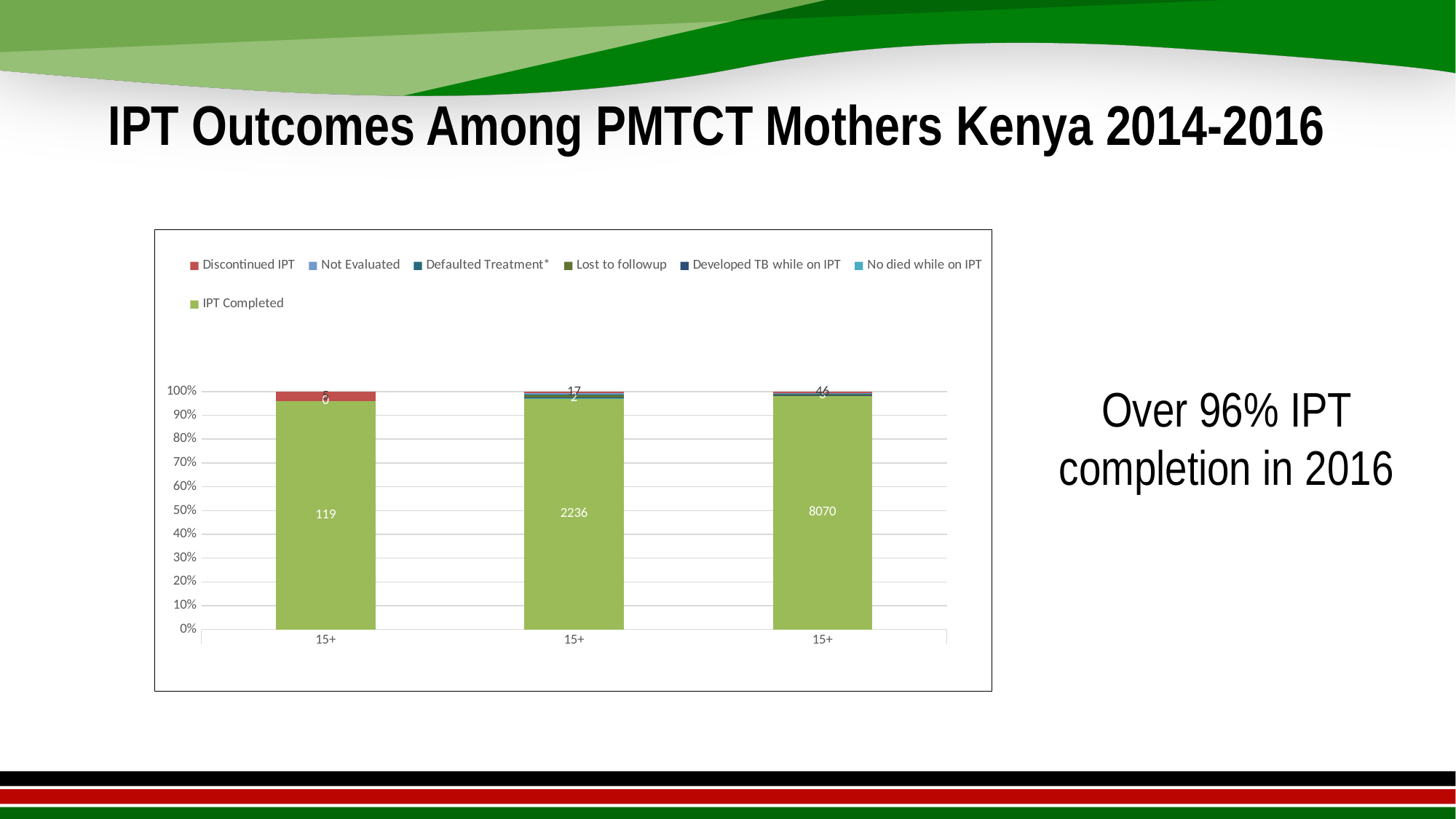
What is the IPT Completed value labelled on the middle bar? 2236 Which bar has the highest IPT Completed count? The rightmost bar (8070) Which is larger, the IPT Completed count of the middle bar or of the leftmost bar? The middle bar How many series does the chart legend list? 7 How many bars are plotted in the chart? 3 What is the IPT Completed value labelled on the rightmost bar? 8070 Is the IPT Completed share of the leftmost bar greater or less than 90%? greater Do the IPT Completed counts rise or fall from the left bar to the right bar? Rise What is the difference between the IPT Completed counts of the rightmost and middle bars? 5834 What kind of chart is shown on the slide? Stacked bar chart Which bar has the lowest IPT Completed count? The leftmost bar (119) What is the IPT Completed value labelled on the leftmost bar? 119